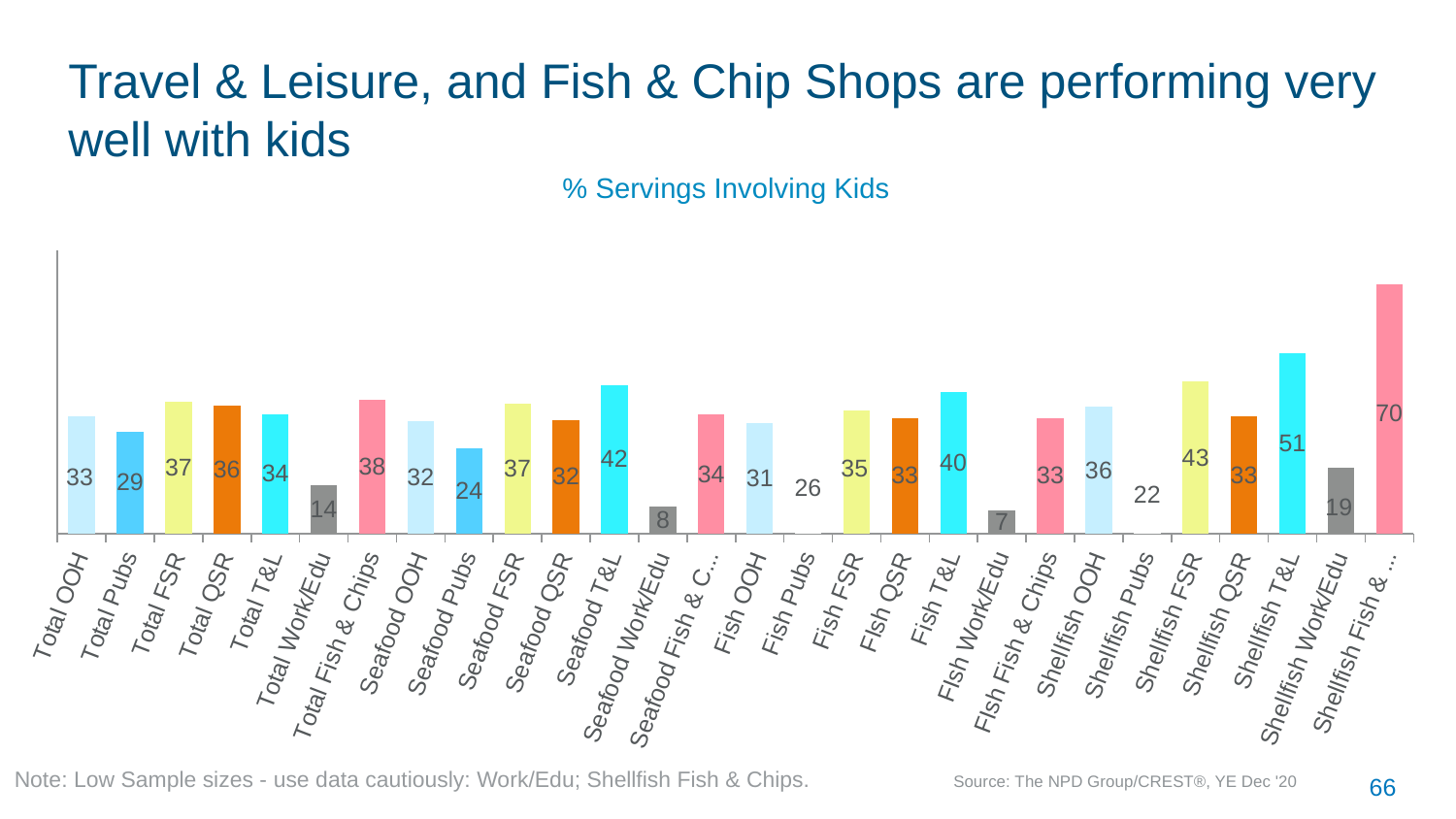
What is the value for Seafood Work/Edu? 8 What kind of chart is shown? Bar chart Which category has the lowest value? Fish Work/Edu What is the title of the chart? % Servings Involving Kids What is the highest value shown on the chart? 70 What is the difference between Shellfish T&L and Total T&L? 17 What is the value for Fish Pubs? 26 How many categories are shown on the chart? 28 Which is larger, Total Pubs or Seafood Pubs? Total Pubs What is the value for Shellfish T&L? 51 What is the value for Total Fish & Chips? 38 Which is larger, Seafood T&L or Fish T&L? Seafood T&L